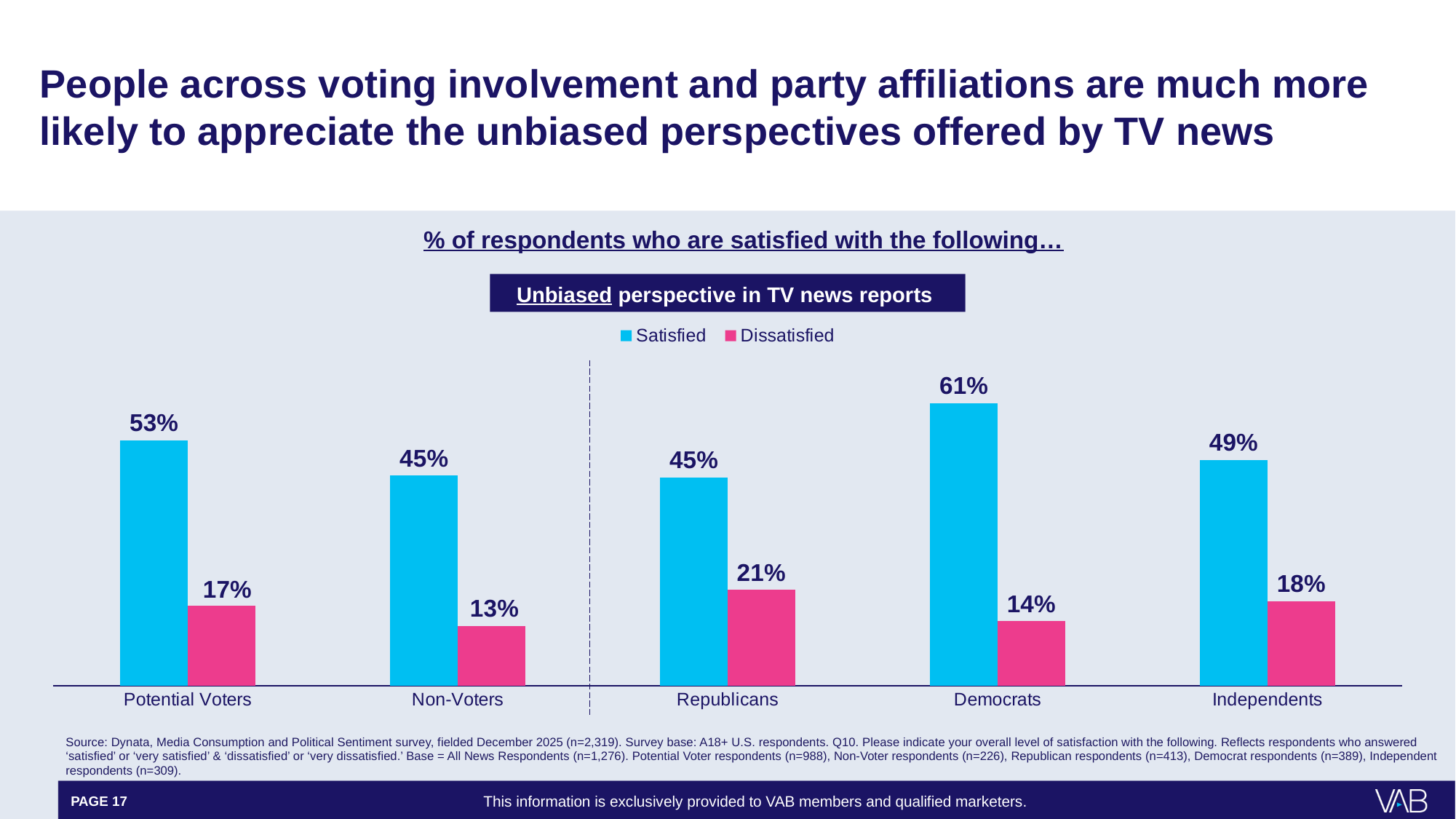
How many categories are shown on the x axis of the chart? 5 What percentage of Democrats are satisfied with the unbiased perspective in TV news reports? 61% What is the difference between the Satisfied and Dissatisfied values for Independents? 31 percentage points What is the difference between the Dissatisfied values for Republicans and Democrats? 7 percentage points Which category has the highest Satisfied value? Democrats What percentage of Republicans are dissatisfied with the unbiased perspective in TV news reports? 21% Which category has the lowest Dissatisfied value? Non-Voters Which is larger, the Satisfied value for Potential Voters or the Satisfied value for Non-Voters? Potential Voters How many series does the legend list? 2 What is the Satisfied value for Potential Voters? 53% What colour are the Dissatisfied bars in the chart? Pink What kind of chart is shown on the slide? Bar chart